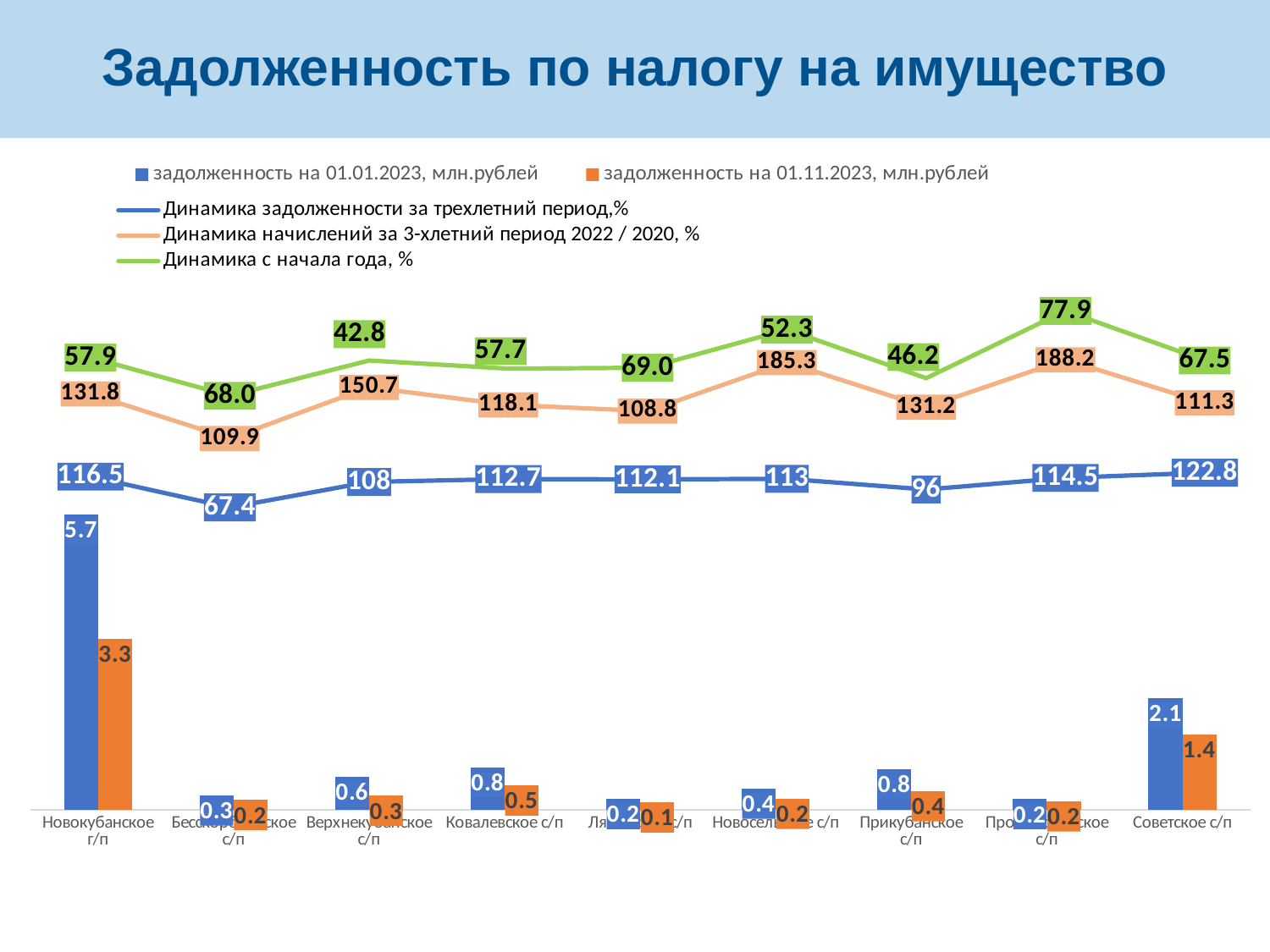
Which category has the highest задолженность на 01.01.2023, млн.рублей? Новокубанское г/п What is the value of задолженность на 01.11.2023, млн.рублей for Советское с/п? 1.4 What kind of chart is shown on the slide? Combined bar and line chart What is the highest value shown for Динамика с начала года, %? 77.9 What is the value of задолженность на 01.01.2023, млн.рублей for Новокубанское г/п? 5.7 What is the difference between задолженность на 01.01.2023 and задолженность на 01.11.2023 for Новокубанское г/п? 2.4 How many series does the legend list? 5 What is the value of Динамика задолженности за трехлетний период,% for Ковалевское с/п? 112.7 For Советское с/п, which is larger: задолженность на 01.01.2023 or задолженность на 01.11.2023? задолженность на 01.01.2023 What is the value of Динамика с начала года, % for Прикубанское с/п? 46.2 What is the title of the chart? Задолженность по налогу на имущество How many categories are shown on the x axis? 9